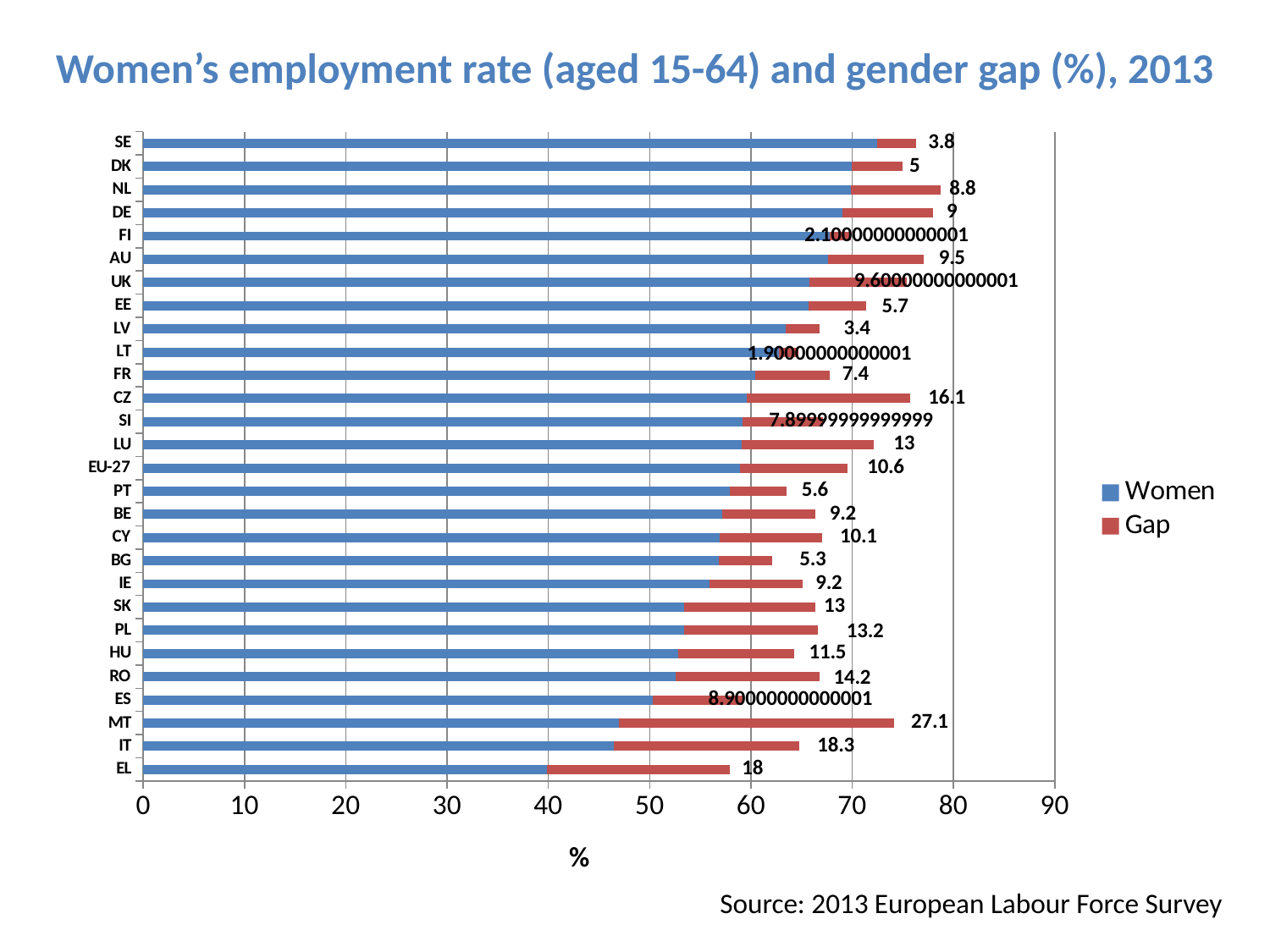
How many series does the legend list? 2 What is the difference between the gender gap values for MT and IT? 8.8 Is the Women employment rate for EL greater or less than 50? less Which country has the largest gender gap value? MT Is the Women employment rate for SE greater or less than 70? greater What kind of chart is shown on the slide? Stacked bar chart How many countries/regions are listed on the y axis of the chart? 28 What is the gender gap value shown for CZ? 16.1 What is the gender gap value shown for EU-27? 10.6 What is the gender gap value shown for MT? 27.1 Which has a larger gender gap value, CZ or LU? CZ Which country has the smallest gender gap value? LT